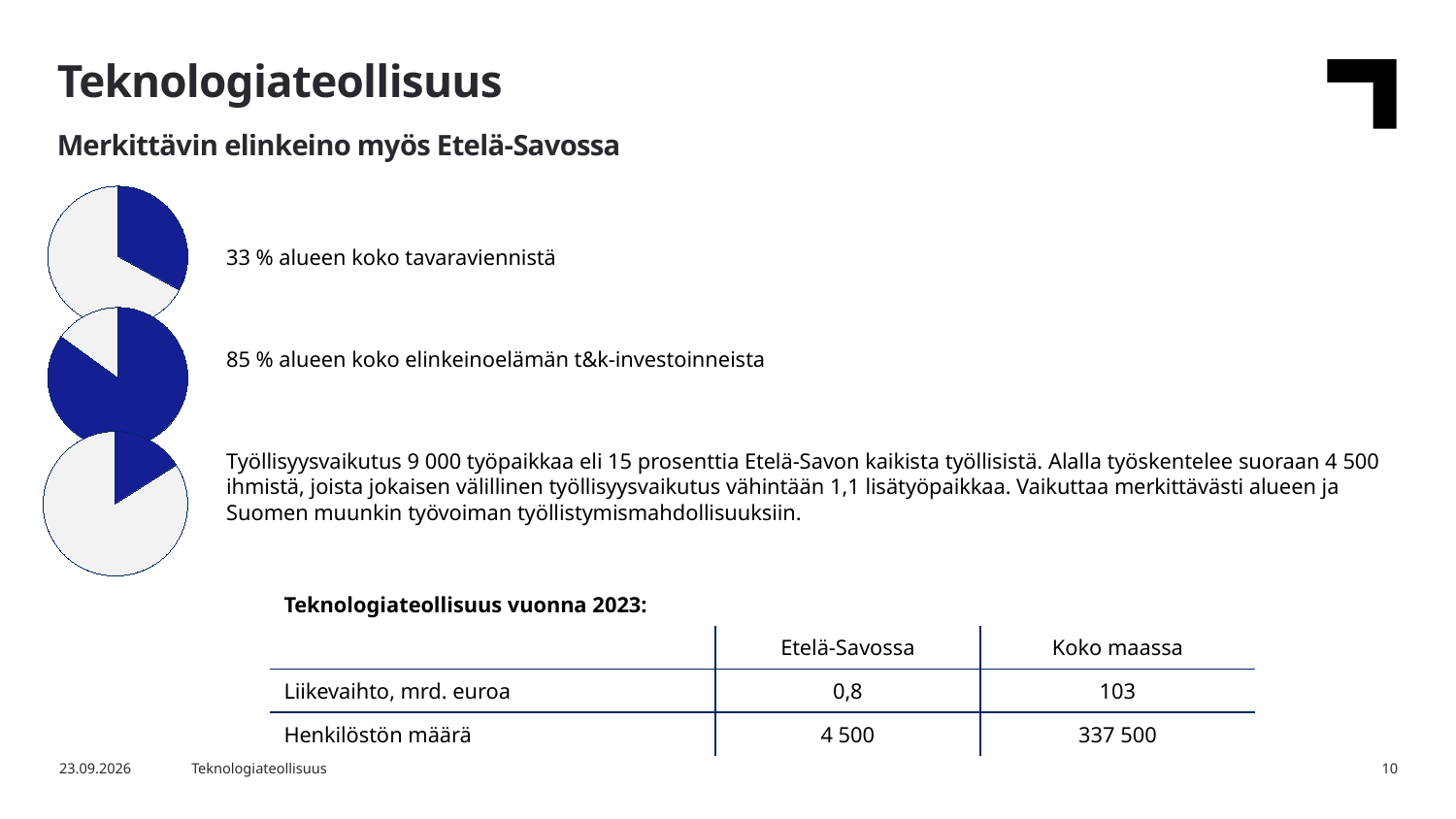
Is the blue slice in the middle pie chart greater or less than half of the pie? greater What colour is used for the highlighted slice in each of the three pie charts? blue How many pie charts are shown on the left side of the slide? 3 In the bottom pie chart, what share of all employed people in Etelä-Savo does the blue slice represent, according to the text beside it? 15 prosenttia Which of the three pie charts has the smallest blue slice: the top, middle or bottom one? bottom Is the blue slice in the bottom pie chart greater or less than half of the pie? less Is the blue slice in the top pie chart larger or smaller than the blue slice in the middle pie chart? smaller In the middle pie chart, what share of the region's business R&D investments does the blue slice represent, according to the text beside it? 85 % What kind of chart is the top chart on the left side of the slide? pie chart How many slices does the top pie chart have? 2 Which of the three pie charts has the largest blue slice: the top, middle or bottom one? middle In the top pie chart, what share of the region's total goods exports does the blue slice represent, according to the text beside it? 33 %